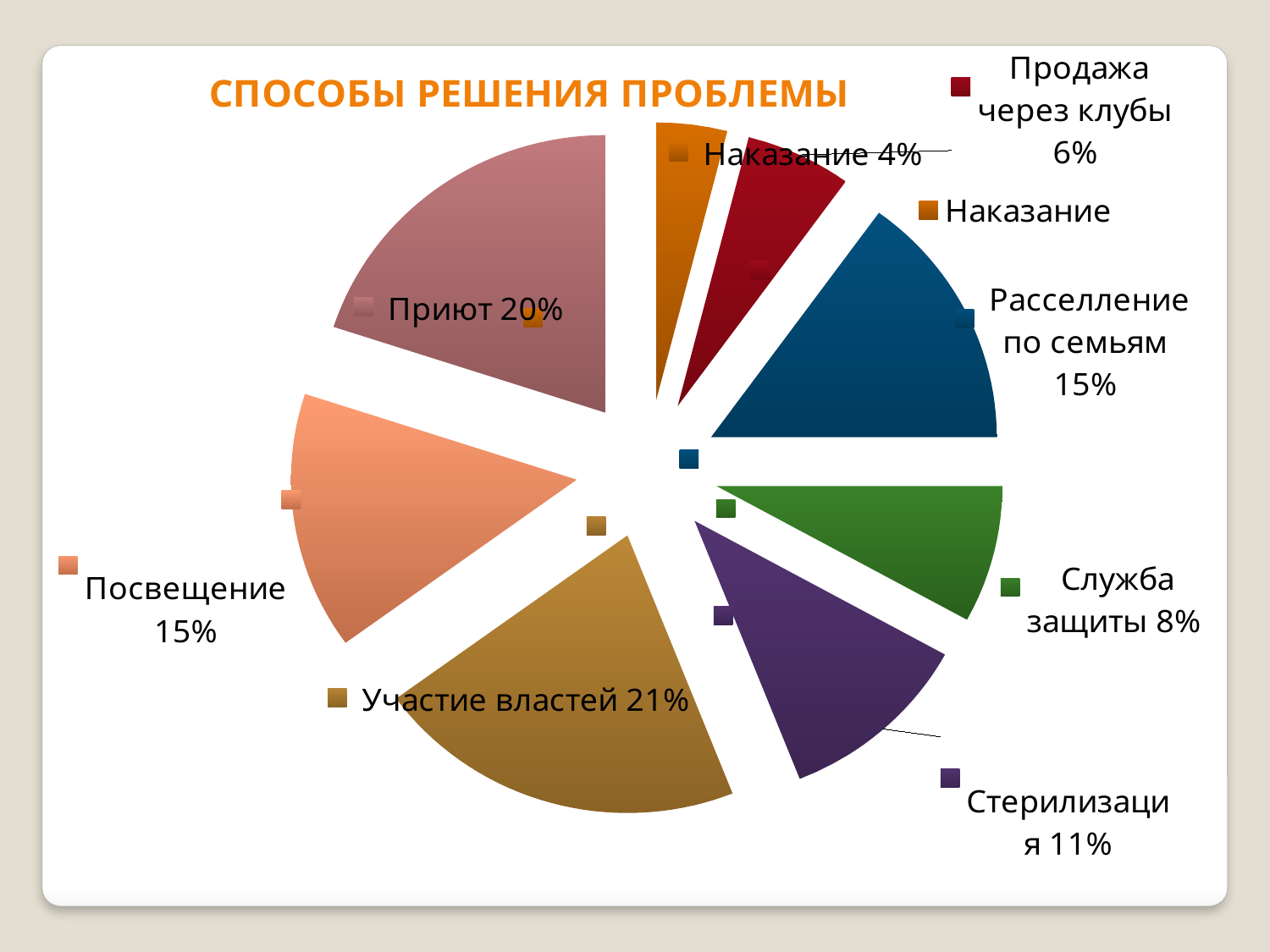
Which category has the largest slice of the pie? Участие властей What is the difference in percentage points between "Участие властей" and "Стерилизация"? 10 What share of the pie is labelled "Участие властей"? 21% What kind of chart is shown on the slide? pie chart What share of the pie is labelled "Стерилизация"? 11% What share of the pie is labelled "Служба защиты"? 8% What is the title of the chart? СПОСОБЫ РЕШЕНИЯ ПРОБЛЕМЫ How many slices does the pie chart have? 8 Which category has the smallest slice of the pie? Наказание Which is larger, the slice for "Расселение по семьям" or the slice for "Служба защиты"? Расселение по семьям